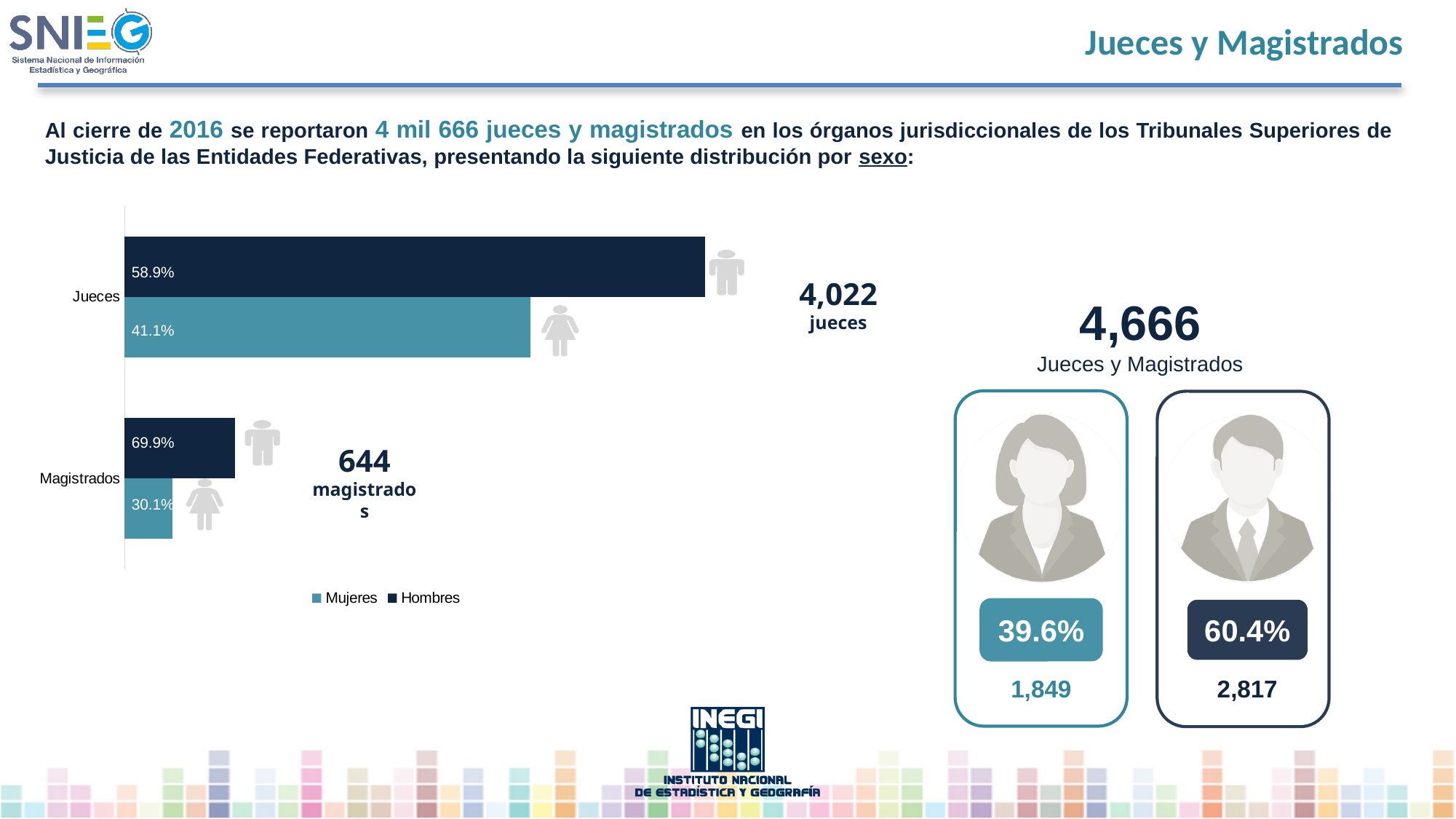
What percentage of Magistrados are Hombres according to the bar chart? 69.9% What type of chart is used to show the distribution by sex? Bar chart How many series does the legend of the bar chart list? 2 What percentage of Jueces are Mujeres according to the bar chart? 41.1% Which category has the higher Hombres percentage, Jueces or Magistrados? Magistrados Which category has the higher Mujeres percentage, Jueces or Magistrados? Jueces What percentage of Magistrados are Mujeres according to the bar chart? 30.1% What is the difference between the Hombres and Mujeres percentages for Magistrados? 39.8% How many categories are shown on the bar chart? 2 What is the difference between the Hombres and Mujeres percentages for Jueces? 17.8% What percentage of Jueces are Hombres according to the bar chart? 58.9% Which series in the bar chart is shown in the dark navy colour? Hombres